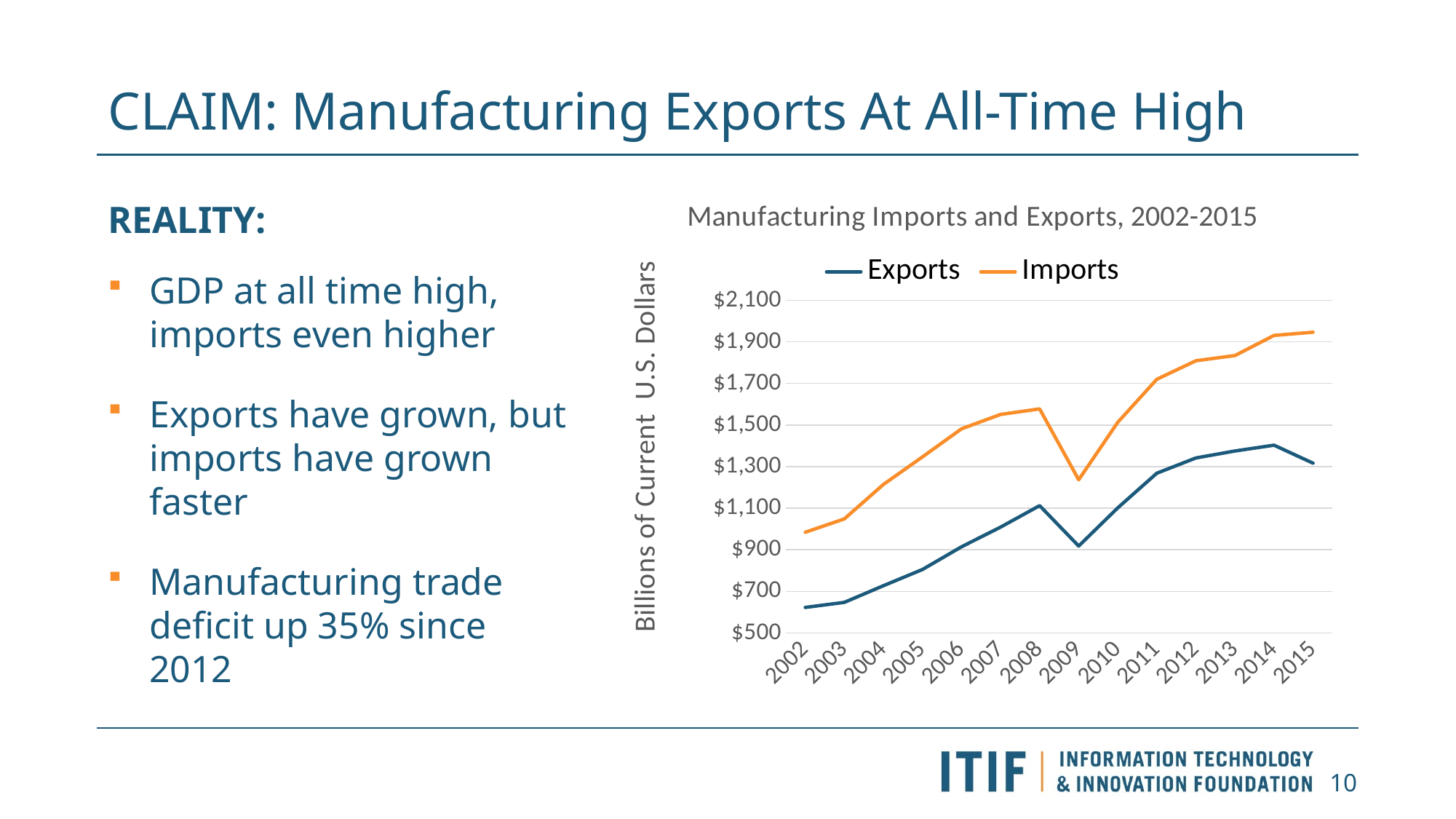
How many series does the legend list? 2 What kind of chart is shown on the slide? line chart In which year is the Exports series at its lowest value? 2002 Is the value for Imports in 2009 greater or less than $1,300? less What is the label of the vertical axis? Billions of Current U.S. Dollars What is the title of the chart? Manufacturing Imports and Exports, 2002-2015 How many years are plotted along the x axis? 14 Is the value for Exports in 2002 greater or less than $700? less Which series has the larger value in 2010, Exports or Imports? Imports Is the value for Imports in 2015 greater or less than $1,900? greater In which year does the Imports series reach its highest value? 2015 In which year does the Exports series reach its highest value? 2014